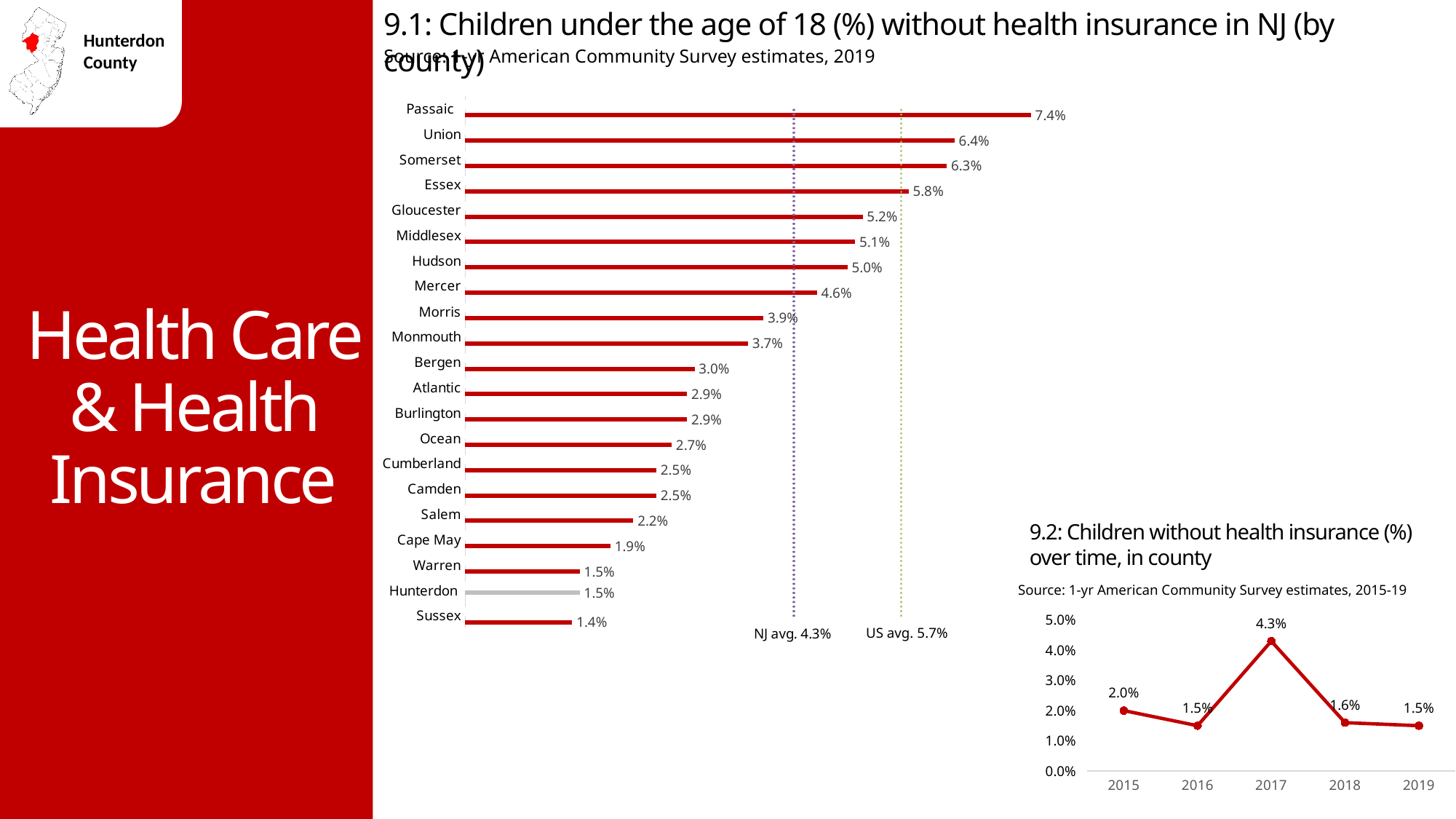
In chart 9.1, which county has the lowest percentage of children without health insurance? Sussex In chart 9.2, what is the value for 2017? 4.3% In chart 9.2, which year has the highest value? 2017 In chart 9.1, how many counties are shown? 21 In chart 9.1, what is the NJ average shown by the dotted line? 4.3% In chart 9.1, what is the difference between the values for Passaic and Sussex? 6.0% In chart 9.2, what is the difference between the values for 2017 and 2018? 2.7% In chart 9.1, which county has the highest percentage of children without health insurance? Passaic What kind of chart is chart 9.2? line chart In chart 9.1, what is the value for Passaic? 7.4% In chart 9.1, which is larger, the value for Mercer or the value for Morris? Mercer In chart 9.1, what is the value for Hunterdon? 1.5%